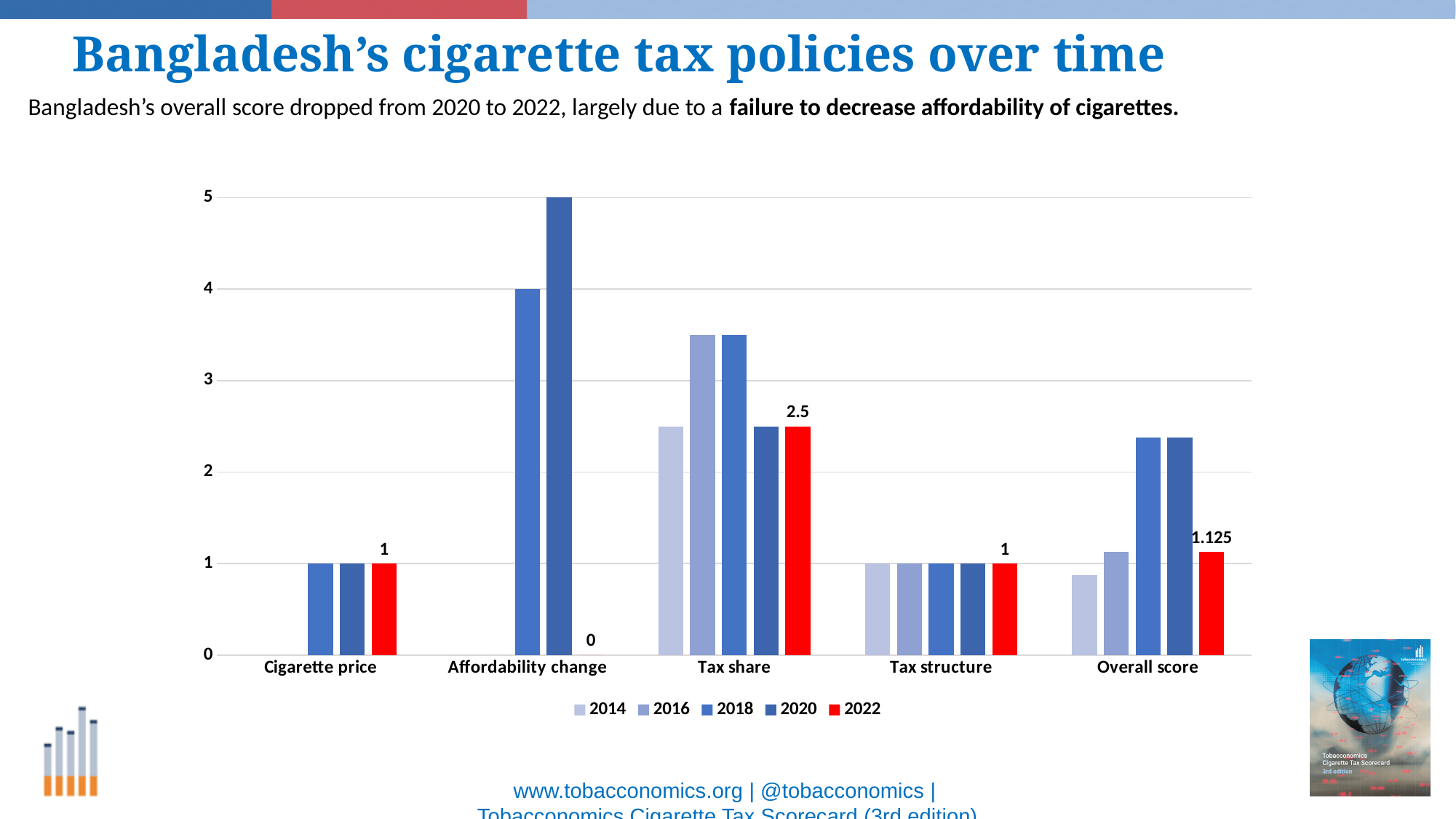
What is the 2020 value for Affordability change? 5 Is the 2016 value for Tax share greater or less than 3? greater What kind of chart is shown on the slide? bar chart What is the 2022 value for Affordability change? 0 How many categories are shown on the x axis? 5 What is the difference between the 2022 values for Tax share and Overall score? 1.375 What is the 2022 value for Overall score? 1.125 How many series does the legend list? 5 What is the 2022 value for Tax share? 2.5 Which is larger in 2022: Tax share or Cigarette price? Tax share Which category has the highest 2022 value? Tax share Which category has the lowest 2022 value? Affordability change